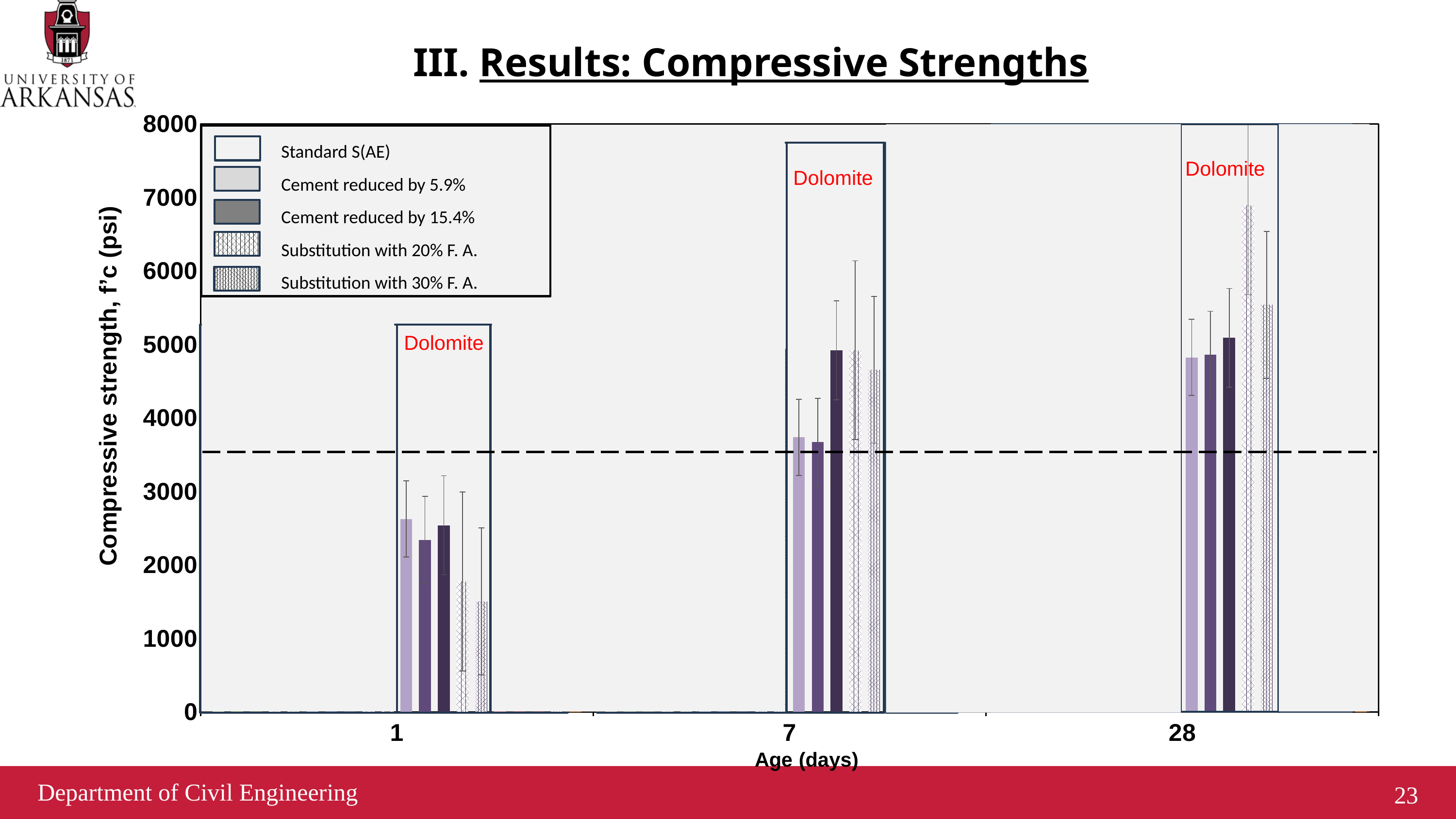
What kind of chart is shown on the slide? bar chart Which series has the highest compressive strength at 28 days? Substitution with 20% F. A. Is the value for Substitution with 20% F. A. at 28 days greater or less than 6000? greater How many age categories are shown on the x axis? 3 Which series has the lowest compressive strength at 1 day? Substitution with 30% F. A. Is the value for Substitution with 30% F. A. at 1 day greater or less than 2000? less What is the label of the y axis? Compressive strength, f'c (psi) How many series does the legend list? 5 Does the compressive strength of Standard S(AE) rise or fall as age increases from 1 to 28 days? rise Is the value for Standard S(AE) at 1 day greater or less than 3000? less What is the label of the x axis? Age (days)